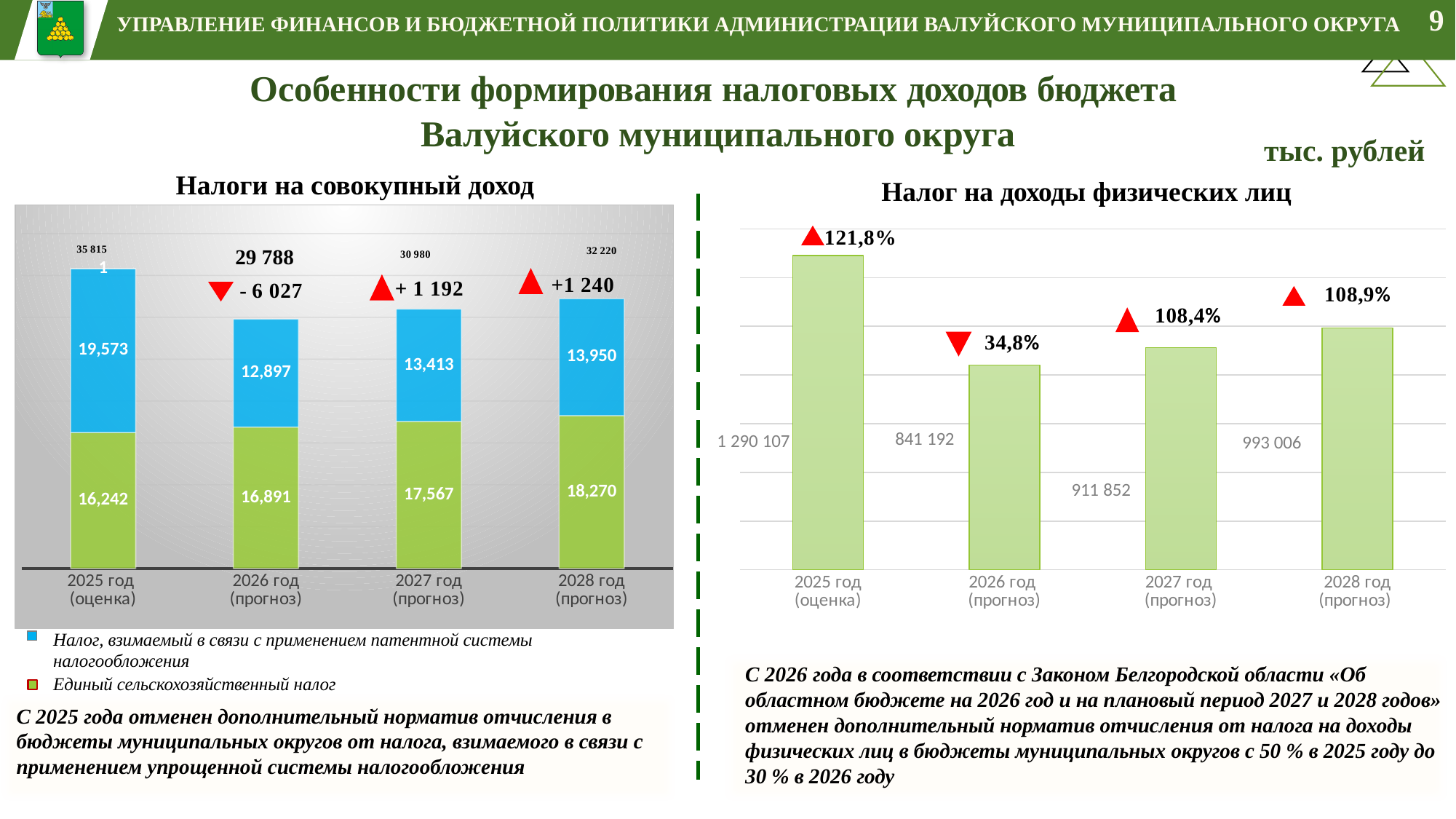
On the chart 'Налоги на совокупный доход', what is the value of Единый сельскохозяйственный налог for 2027 год (прогноз)? 17,567 On the chart 'Налоги на совокупный доход', how many series does the legend list? 2 On the chart 'Налоги на совокупный доход', what is the change shown between 2025 and 2026? - 6 027 On the chart 'Налог на доходы физических лиц', what percentage is shown above the 2026 год (прогноз) bar? 34,8% On the chart 'Налог на доходы физических лиц', which year has the lowest value? 2026 год (прогноз) What kind of chart is 'Налог на доходы физических лиц'? Bar chart On the chart 'Налог на доходы физических лиц', what is the value for 2025 год (оценка)? 1 290 107 On the chart 'Налоги на совокупный доход', which year has the lowest value for Единый сельскохозяйственный налог? 2025 год (оценка) On the chart 'Налоги на совокупный доход', what is the value of the patent-system tax (Налог, взимаемый в связи с применением патентной системы налогообложения) for 2025 год (оценка)? 19,573 On the chart 'Налоги на совокупный доход', what is the total of the stacked bar for 2026 год (прогноз)? 29 788 On the chart 'Налоги на совокупный доход', which year has the highest total? 2025 год (оценка) On the chart 'Налог на доходы физических лиц', what is the value for 2028 год (прогноз)? 993 006